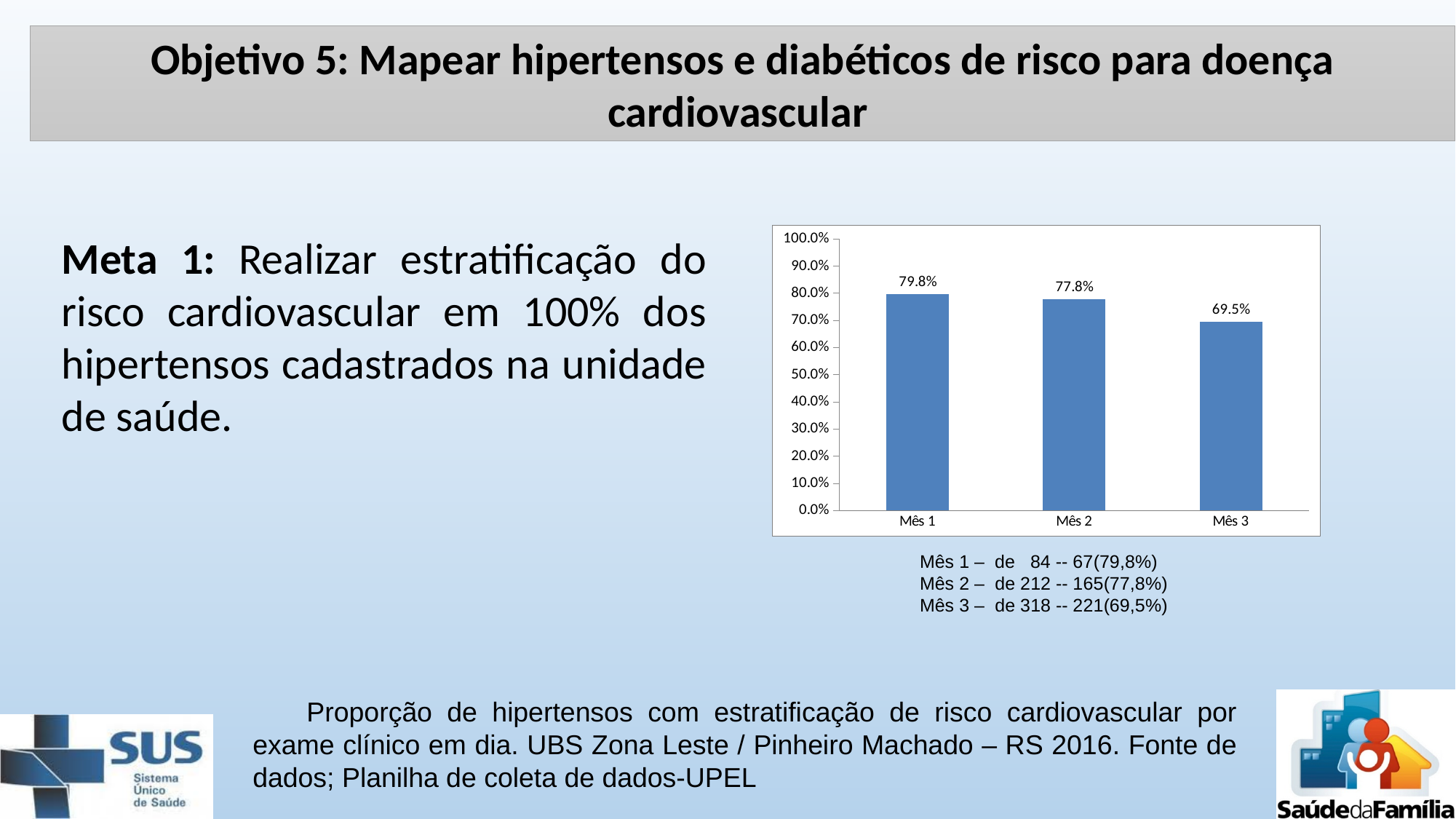
What is the difference between the values for Mês 1 and Mês 3? 10.3% Which is larger, the value for Mês 2 or the value for Mês 3? Mês 2 Is the value for Mês 3 greater or less than 70.0%? less How many months are shown on the chart? 3 What is the difference between the values for Mês 2 and Mês 3? 8.3% Which month has the highest value? Mês 1 Which month has the lowest value? Mês 3 What is the value for Mês 1? 79.8% What kind of chart is shown on the slide? bar chart Do the values rise or fall from Mês 1 to Mês 3? fall What is the value for Mês 2? 77.8% What is the value for Mês 3? 69.5%